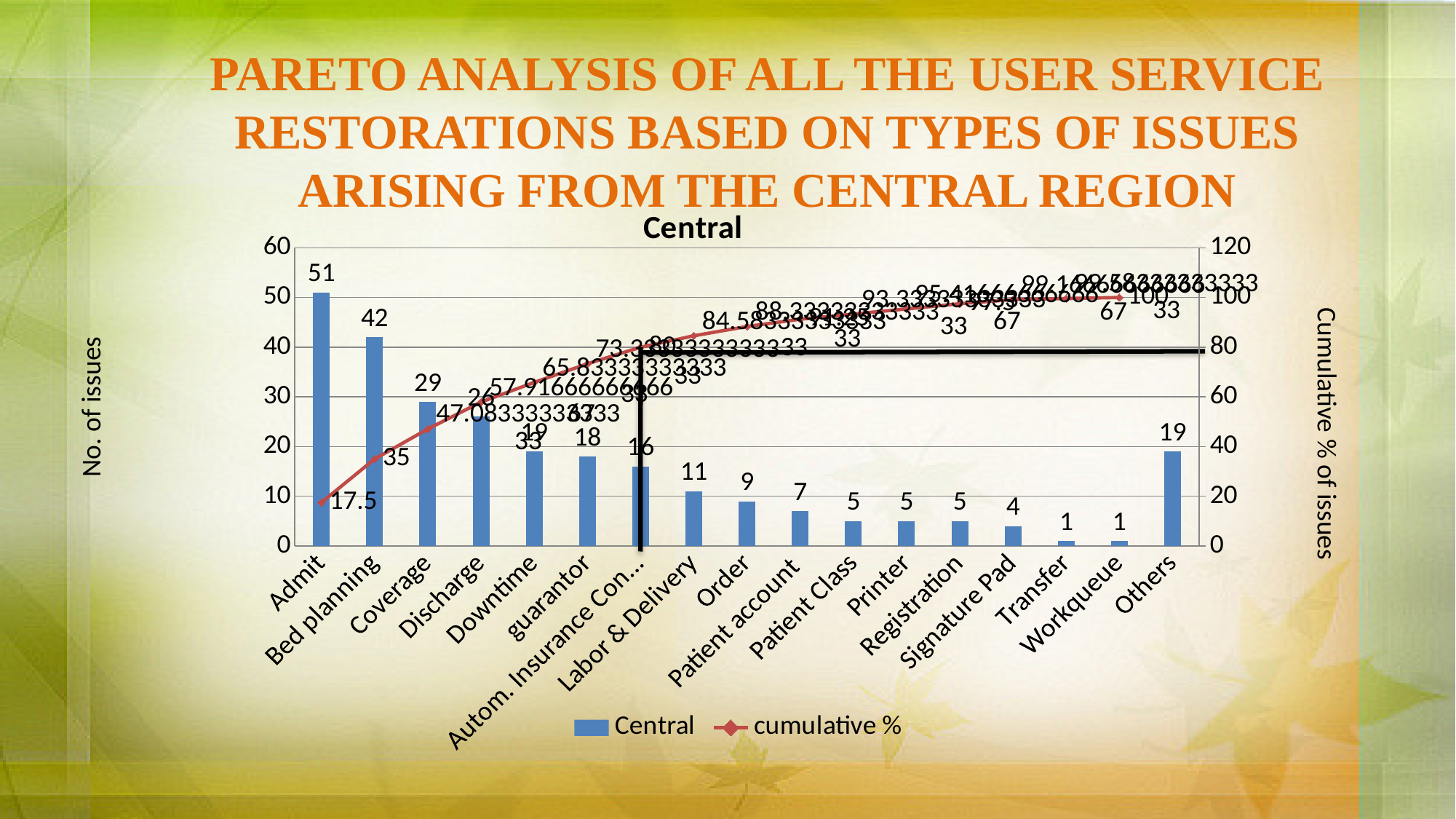
What is the number of issues for Labor & Delivery? 11 What is the number of issues for Others? 19 What is the cumulative % value for Admit? 17.5 What is the number of issues for Bed planning? 42 How many series does the legend list? 2 Which has more issues, Coverage or Discharge? Coverage What is the difference in number of issues between Admit and Bed planning? 9 What is the label of the left vertical axis? No. of issues What is the chart title shown above the plot area? Central How many categories are shown on the x axis? 17 What is the number of issues for Admit? 51 Which category has the highest number of issues? Admit